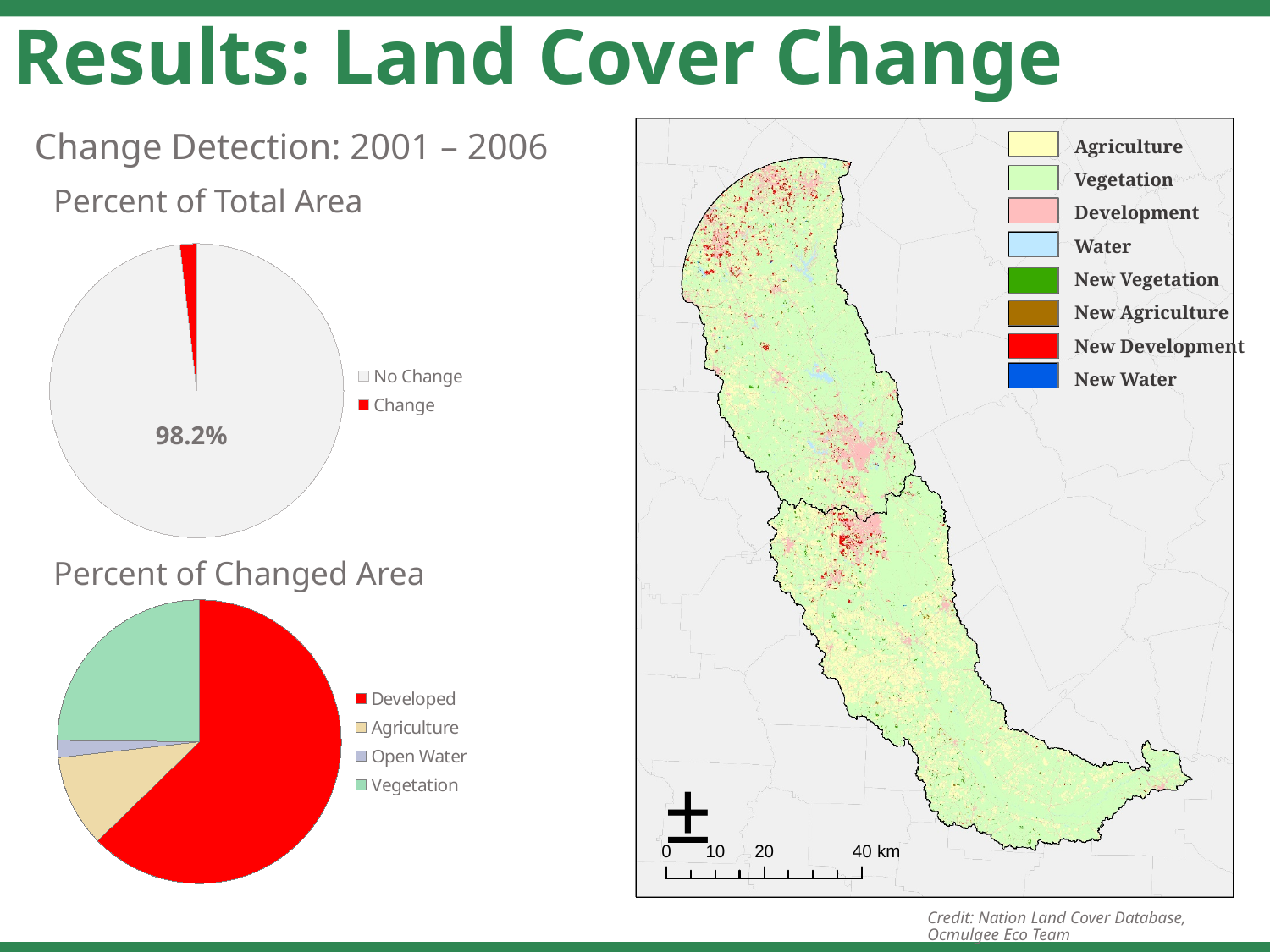
What kind of chart is the "Percent of Total Area" chart? Pie chart In the "Percent of Total Area" chart, which category has the largest share? No Change In the "Percent of Total Area" chart, which category has the smallest share? Change How many categories does the "Percent of Total Area" pie chart have? 2 In the "Percent of Changed Area" chart, which category has the largest share? Developed In the "Percent of Changed Area" chart, which category has the smallest share? Open Water In the "Percent of Changed Area" chart, which is larger, Agriculture or Vegetation? Vegetation What kind of chart is the "Percent of Changed Area" chart? Pie chart In the "Percent of Total Area" chart, what value is shown for No Change? 98.2% How many categories does the "Percent of Changed Area" pie chart have? 4 In the "Percent of Changed Area" chart, which is larger, Developed or Agriculture? Developed In the "Percent of Changed Area" chart, what colour is the Developed slice? Red